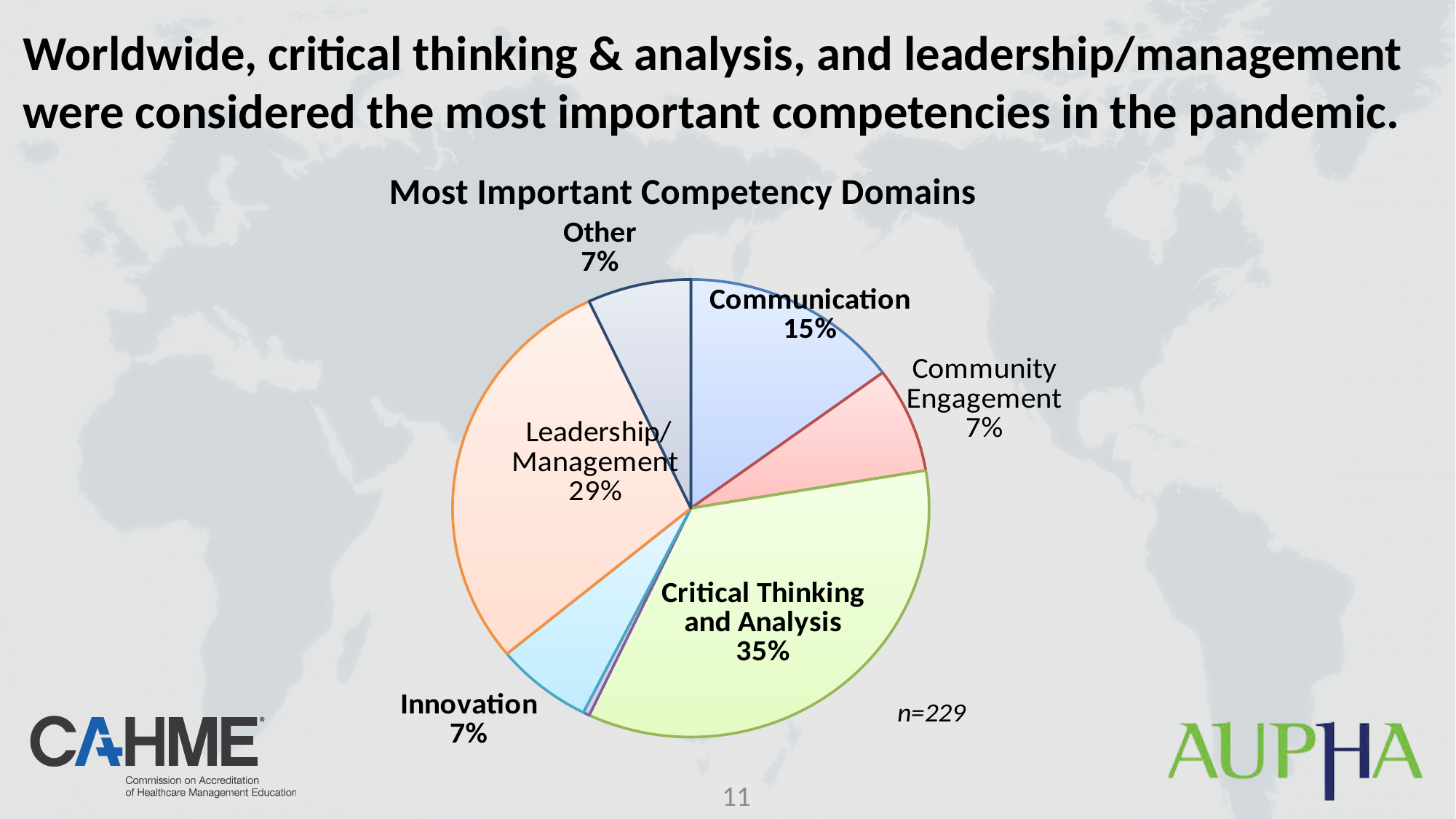
What share of the pie does Critical Thinking and Analysis represent? 35% What percentage is shown for Innovation? 7% What sample size (n) is noted on the chart? n=229 Which competency domain has the largest share of the pie? Critical Thinking and Analysis Which is larger, the share for Leadership/Management or the share for Communication? Leadership/Management What percentage is shown for Community Engagement? 7% What is the difference in percentage points between Communication and Other? 8 What percentage is shown for Leadership/Management? 29% What is the title of the chart? Most Important Competency Domains What percentage is shown for Communication? 15% What is the difference in percentage points between Critical Thinking and Analysis and Leadership/Management? 6 What type of chart is shown on the slide? pie chart